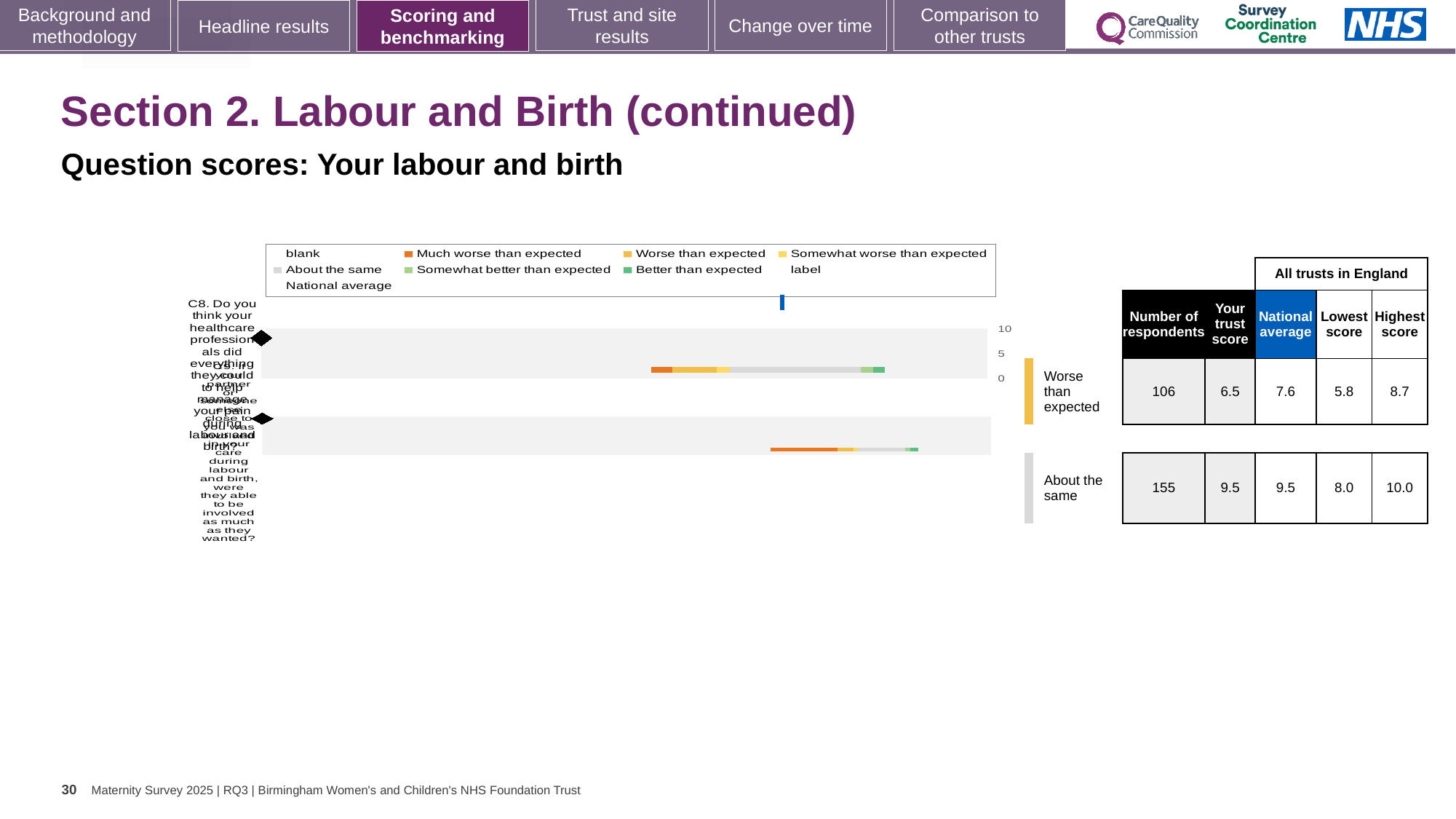
In the table, what is the lowest score for the question rated 'About the same'? 8.0 In the table, what is the national average for the question rated 'Worse than expected'? 7.6 For the question rated 'Worse than expected', how much lower is the trust score than the national average? 1.1 What kind of chart is shown on the slide? Bar chart How many questions (bars) are plotted in the chart? 2 In the table, what is the highest score for the question rated 'Worse than expected'? 8.7 Which of the two questions has more respondents: the one rated 'Worse than expected' or the one rated 'About the same'? About the same In the table, what is the number of respondents for the question rated 'Worse than expected'? 106 What benchmark category is the first question (C8, about managing pain during labour and birth) rated as? Worse than expected For the question rated 'Worse than expected', which is larger: the trust score or the national average? National average For the question rated 'Worse than expected', what is the difference between the highest score and the lowest score? 2.9 In the table, what is the trust score for the question rated 'About the same'? 9.5